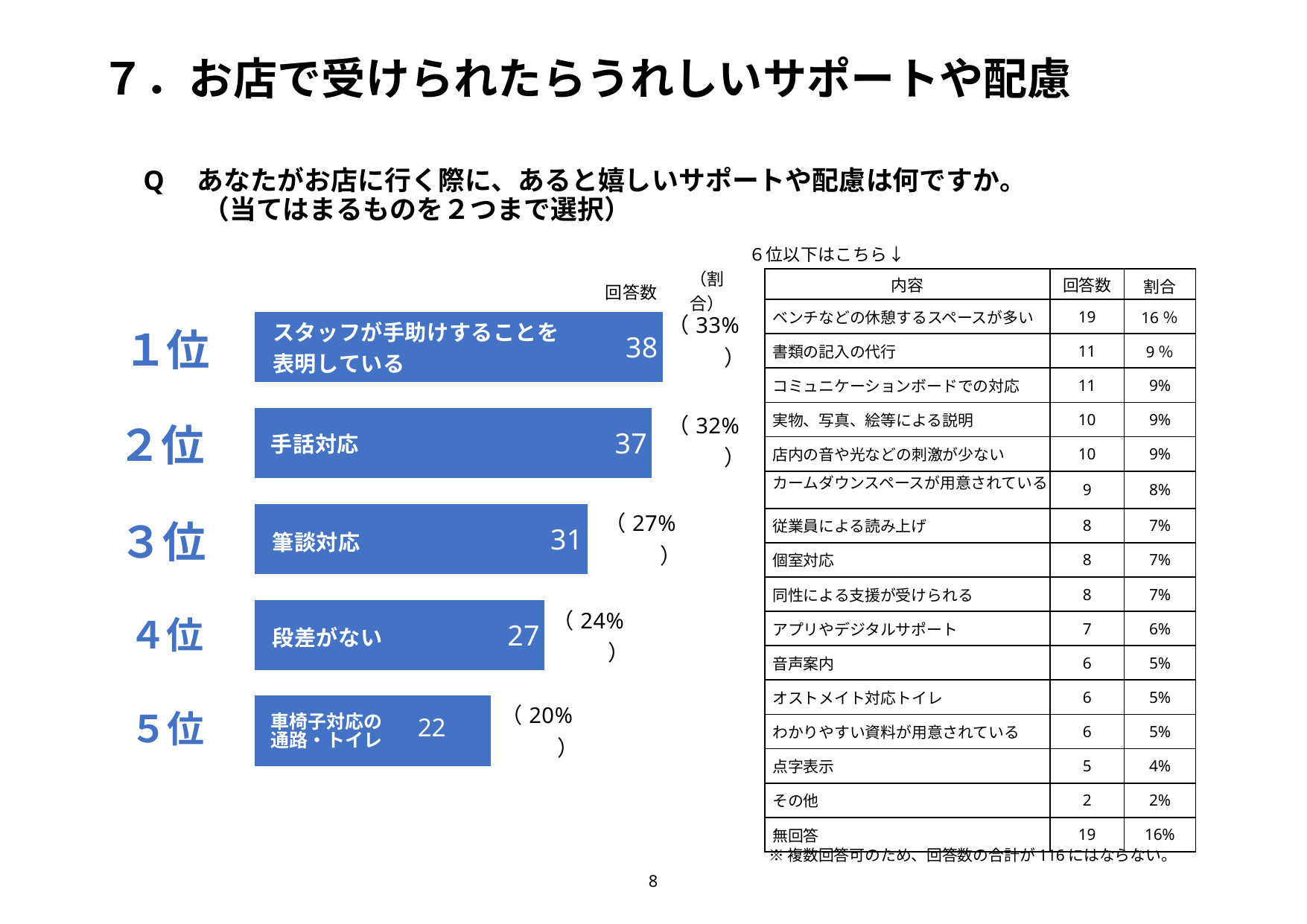
Do the bar values rise or fall from 1位 to 5位? fall Which has more responses, 手話対応 or 車椅子対応の通路・トイレ? 手話対応 How many bars are shown in the bar chart? 5 Which category has the lowest number of responses in the bar chart? 車椅子対応の通路・トイレ What percentage (割合) is shown for 車椅子対応の通路・トイレ? 20% What kind of chart is shown on the left of the slide? bar chart What percentage (割合) is shown for スタッフが手助けすることを表明している? 33% What is the number of responses (回答数) for 段差がない? 27 Which category has the highest number of responses in the bar chart? スタッフが手助けすることを表明している What is the number of responses (回答数) for 手話対応? 37 What is the difference in responses between 筆談対応 and 段差がない? 4 What is the number of responses (回答数) for 筆談対応? 31